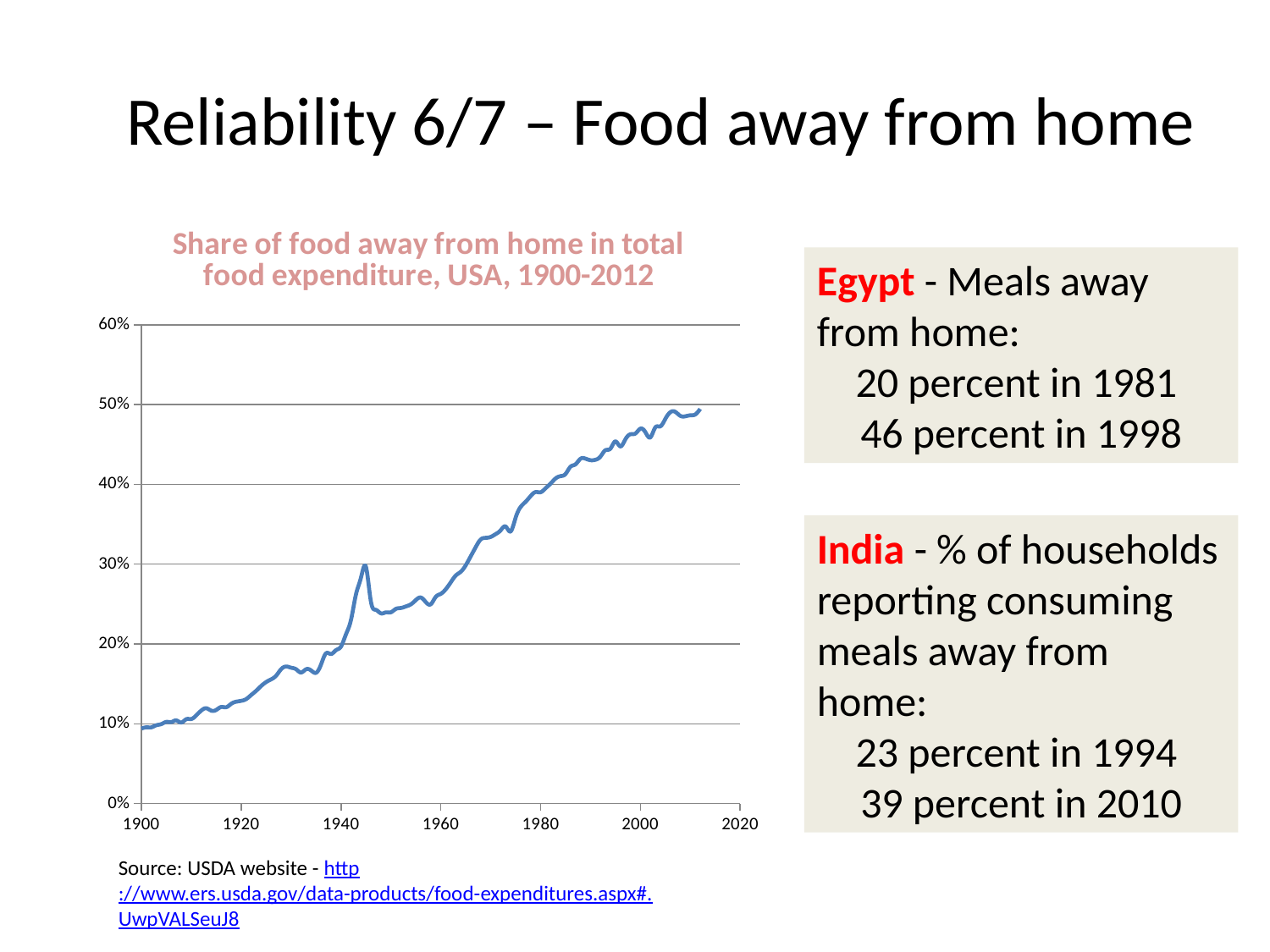
Is the value for 2010 greater or less than 40%? greater How many lines are plotted on the chart? 1 Is the value for 1980 greater or less than 30%? greater What kind of chart is shown on the slide? line chart Is the value for 1920 greater or less than 20%? less Does the share of food away from home generally rise or fall from 1900 to 2012? rise Which year has the larger share of food away from home, 1900 or 2010? 2010 Which is larger, the value at the spike around 1945 or the value in 1950? around 1945 What is the title of the chart? Share of food away from home in total food expenditure, USA, 1900-2012